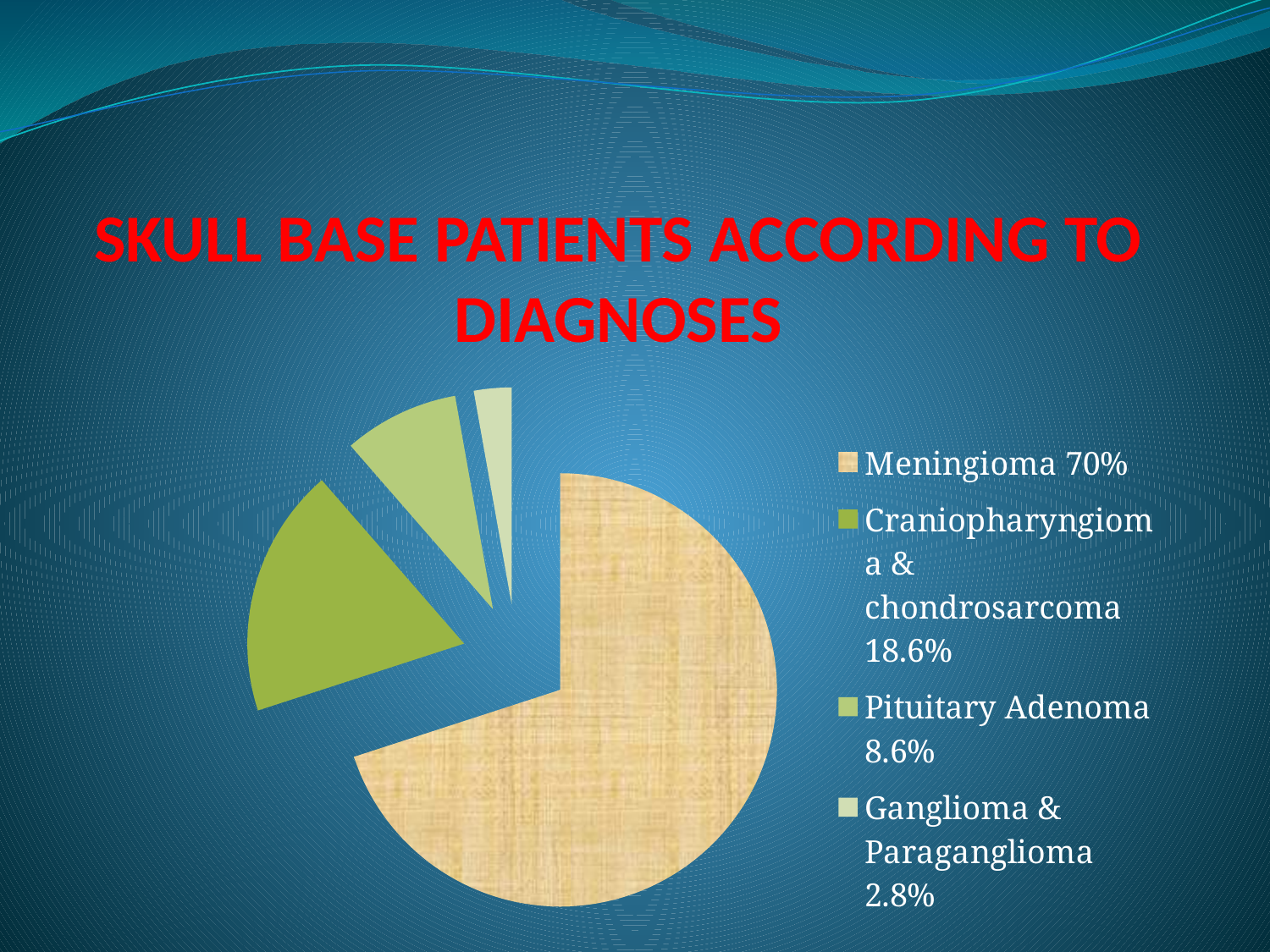
Which diagnosis has the largest share of the pie? Meningioma What is the difference in percentage points between Pituitary Adenoma and Ganglioma & Paraganglioma? 5.8 Which is larger, the share for Pituitary Adenoma or the share for Ganglioma & Paraganglioma? Pituitary Adenoma What percentage of skull base patients have Meningioma? 70% What is the difference in percentage points between Meningioma and Craniopharyngioma & chondrosarcoma? 51.4 What kind of chart is shown on the slide? pie chart How many diagnosis categories does the pie chart show? 4 What is the title of the slide containing the pie chart? SKULL BASE PATIENTS ACCORDING TO DIAGNOSES What percentage is shown for Craniopharyngioma & chondrosarcoma? 18.6% What percentage is shown for Ganglioma & Paraganglioma? 2.8% What percentage is shown for Pituitary Adenoma? 8.6% Which diagnosis has the smallest share of the pie? Ganglioma & Paraganglioma